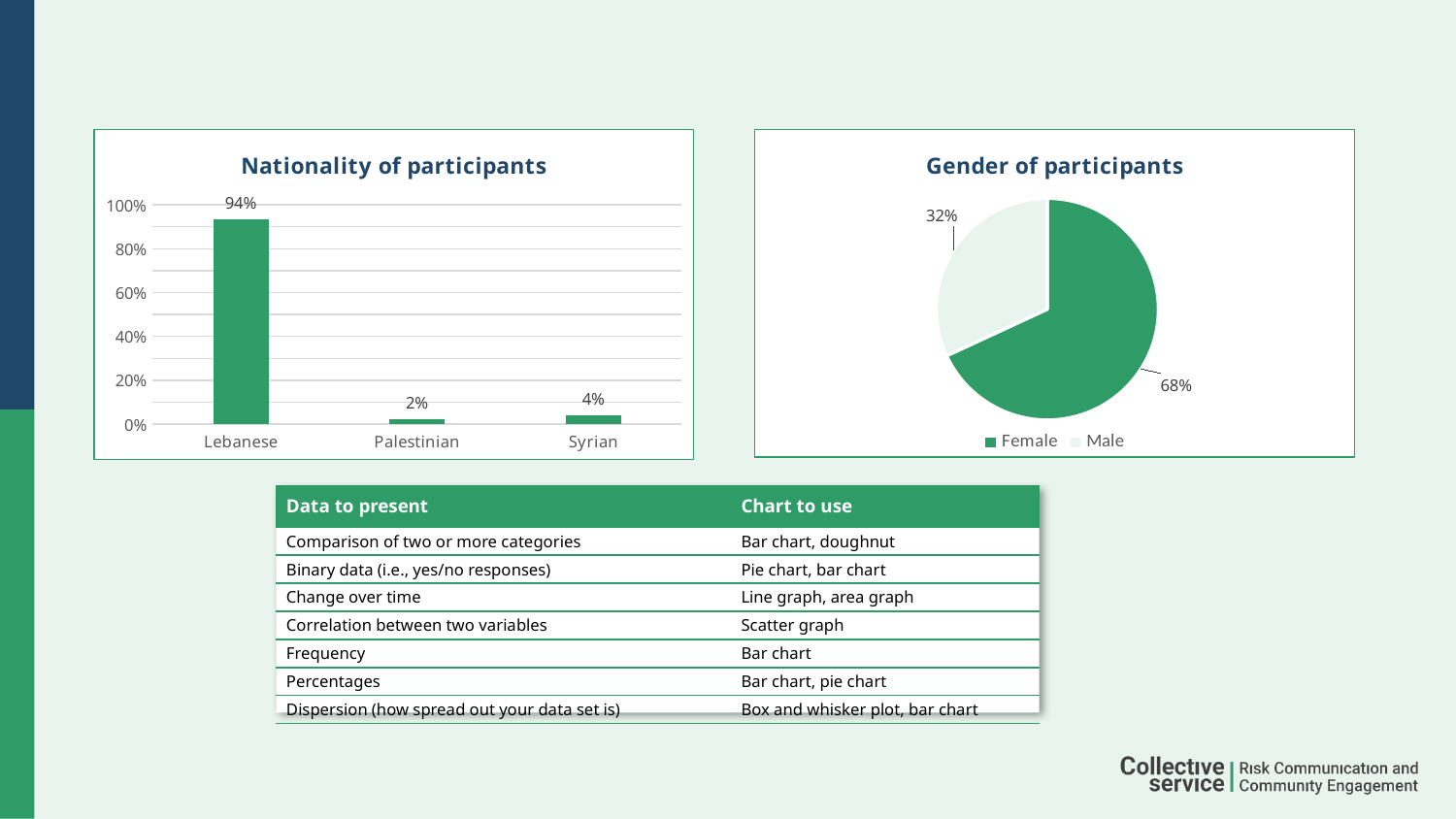
What kind of chart is 'Nationality of participants'? Bar chart In the 'Gender of participants' chart, what share of participants is Female? 68% In the 'Nationality of participants' chart, what is the difference between the Lebanese and Syrian values? 90% What kind of chart is 'Gender of participants'? Pie chart How many entries does the legend of the 'Gender of participants' chart list? 2 In the 'Nationality of participants' chart, which nationality has the highest value? Lebanese In the 'Nationality of participants' chart, how many nationality categories are shown? 3 In the 'Nationality of participants' chart, what is the value for Lebanese? 94% In the 'Nationality of participants' chart, which nationality has the lowest value? Palestinian In the 'Nationality of participants' chart, what is the value for Syrian? 4% In the 'Gender of participants' chart, what share of participants is Male? 32% In the 'Nationality of participants' chart, which is larger, the value for Syrian or the value for Palestinian? Syrian